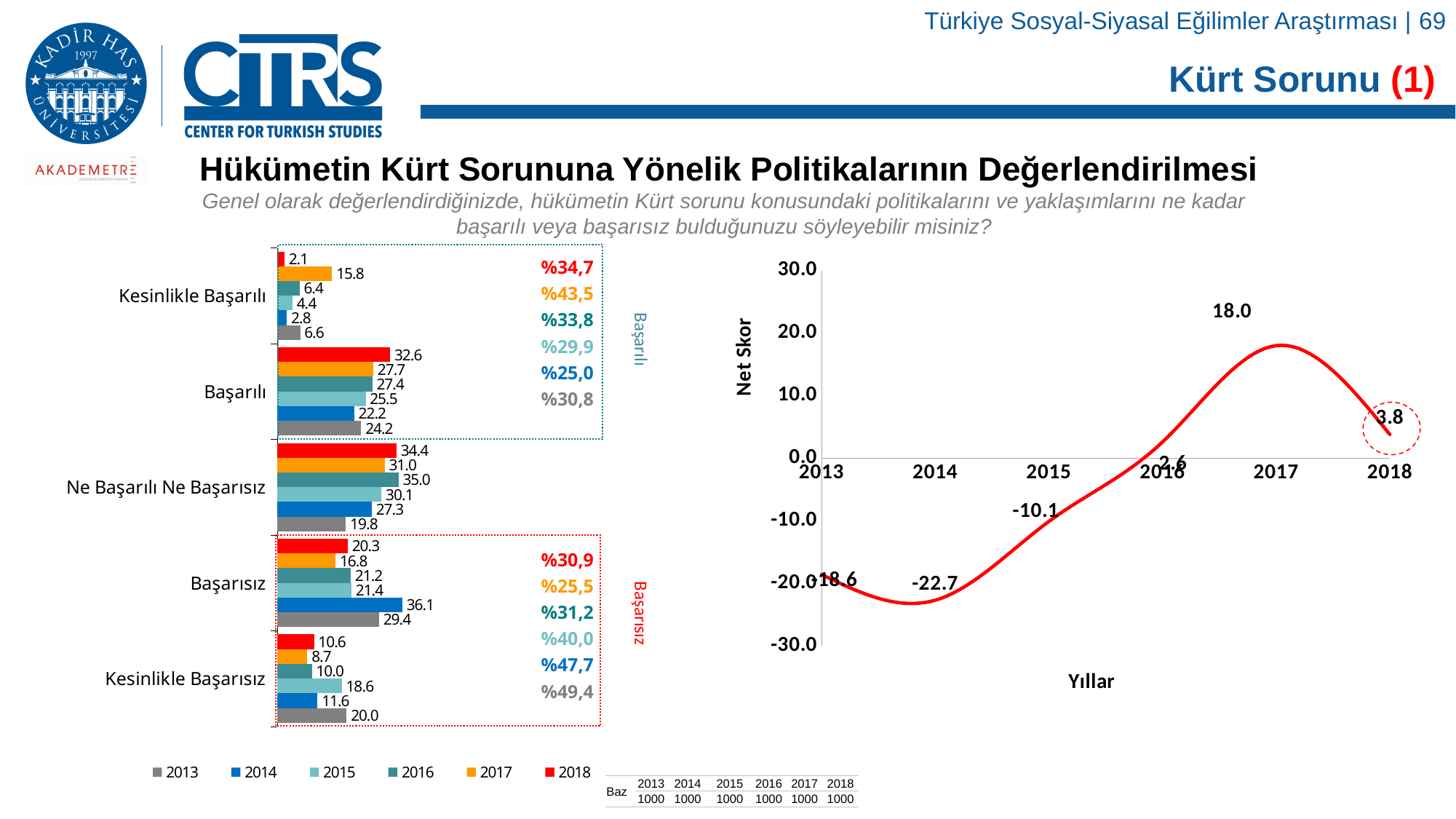
On the left bar chart, which year has the lowest value in the Kesinlikle Başarılı category? 2018 On the left bar chart, what is the value for 2017 in the Kesinlikle Başarılı category? 15.8 On the left bar chart, what is the value for 2014 in the Başarısız category? 36.1 On the left bar chart, what is the difference between the 2018 and 2013 values in the Başarılı category? 8.4 How many categories are shown on the left bar chart? 5 On the left bar chart, what is the value for 2013 in the Kesinlikle Başarısız category? 20.0 On the right Net Skor chart, which year has the lowest value? 2014 On the left bar chart, which is larger in the Başarısız category: the 2013 value or the 2018 value? 2013 On the right Net Skor chart, what is the value for 2017? 18.0 On the left bar chart, which year has the highest value in the Ne Başarılı Ne Başarısız category? 2016 What kind of chart is the right-hand Net Skor chart? Line chart How many series does the legend of the left bar chart list? 6